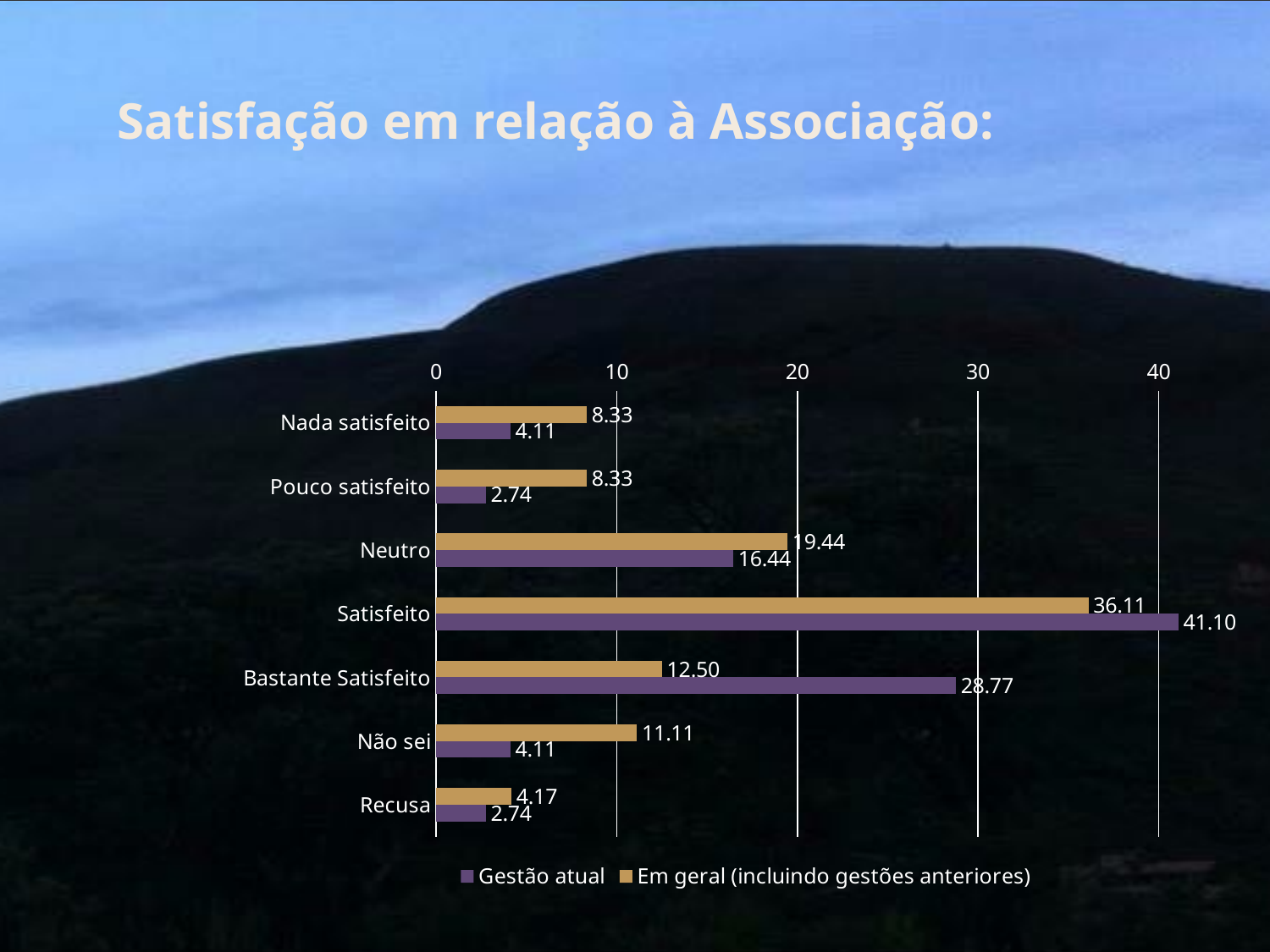
What is the value for Bastante Satisfeito in the Gestão atual series? 28.77 How many series does the legend list? 2 Which category has the highest value in the Em geral (incluindo gestões anteriores) series? Satisfeito How many categories are shown on the chart? 7 For Não sei, which series has the larger value, Gestão atual or Em geral (incluindo gestões anteriores)? Em geral (incluindo gestões anteriores) What is the value for Neutro in the Em geral (incluindo gestões anteriores) series? 19.44 What kind of chart is shown on the slide? Bar chart What is the difference between the Gestão atual and Em geral values for Bastante Satisfeito? 16.27 Which category has the lowest value in the Em geral (incluindo gestões anteriores) series? Recusa Is the Gestão atual value for Satisfeito greater or less than 40? greater What is the title of the slide? Satisfação em relação à Associação: What is the value for Satisfeito in the Gestão atual series? 41.10